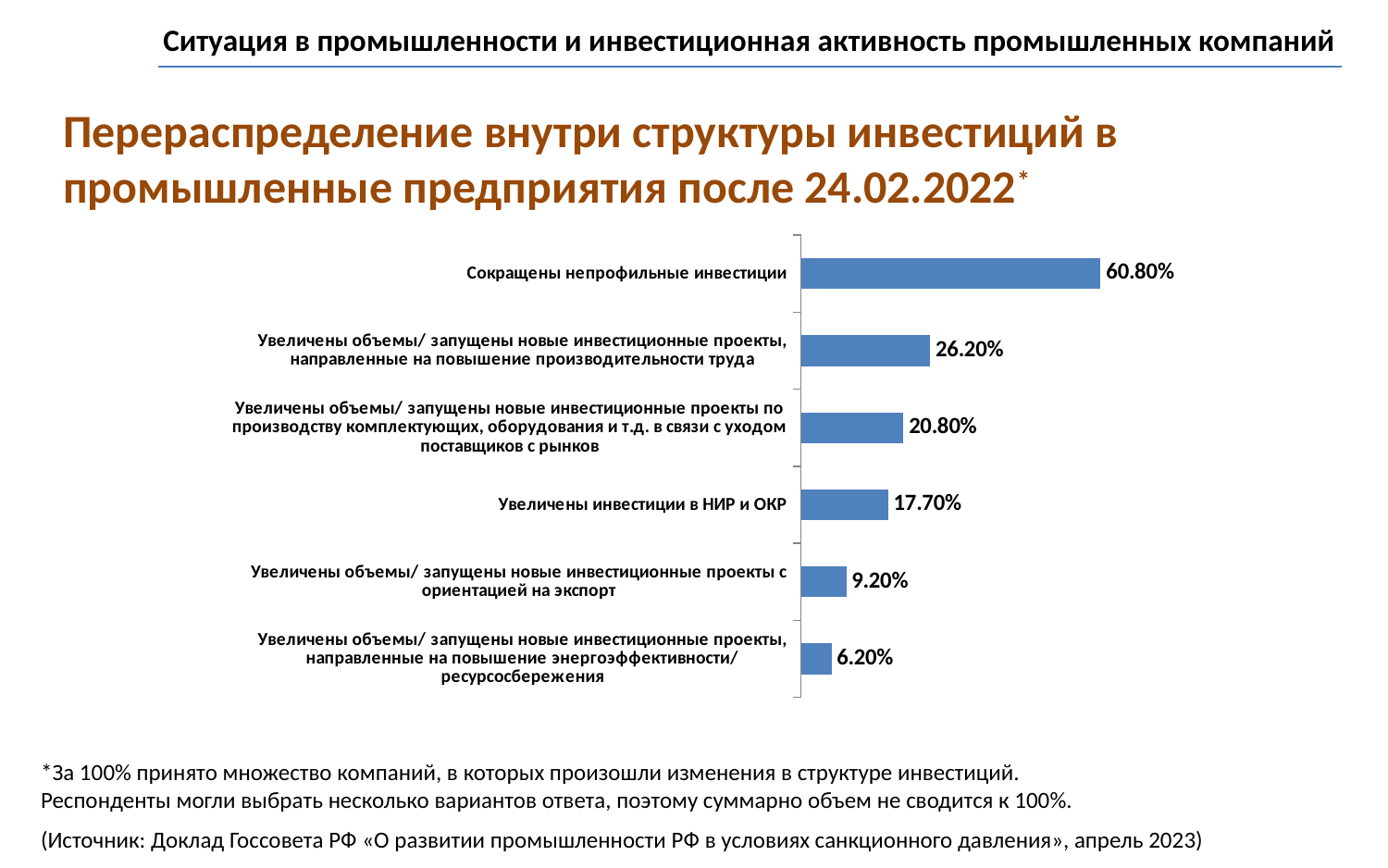
Which category has the highest value? Сокращены непрофильные инвестиции Which is larger: the value for projects aimed at raising labour productivity ("повышение производительности труда") or the value for projects producing components and equipment due to suppliers leaving the market? повышение производительности труда (26.20%) What kind of chart is shown on the slide? bar chart What is the value for "Сокращены непрофильные инвестиции"? 60.80% Which category has the lowest value? Увеличены объемы/ запущены новые инвестиционные проекты, направленные на повышение энергоэффективности/ ресурсосбережения What is the difference between the value for "Сокращены непрофильные инвестиции" and the value for projects aimed at raising labour productivity ("повышение производительности труда")? 34.60% What is the difference between the value for "Увеличены инвестиции в НИР и ОКР" and the value for export-oriented projects ("с ориентацией на экспорт")? 8.50% What is the value for the category about investment projects aimed at energy efficiency / resource saving ("повышение энергоэффективности/ ресурсосбережения")? 6.20% How many categories does the chart show? 6 What is the value for "Увеличены объемы/ запущены новые инвестиционные проекты с ориентацией на экспорт"? 9.20% What is the value for "Увеличены инвестиции в НИР и ОКР"? 17.70% What is the title of the chart on the slide? Перераспределение внутри структуры инвестиций в промышленные предприятия после 24.02.2022